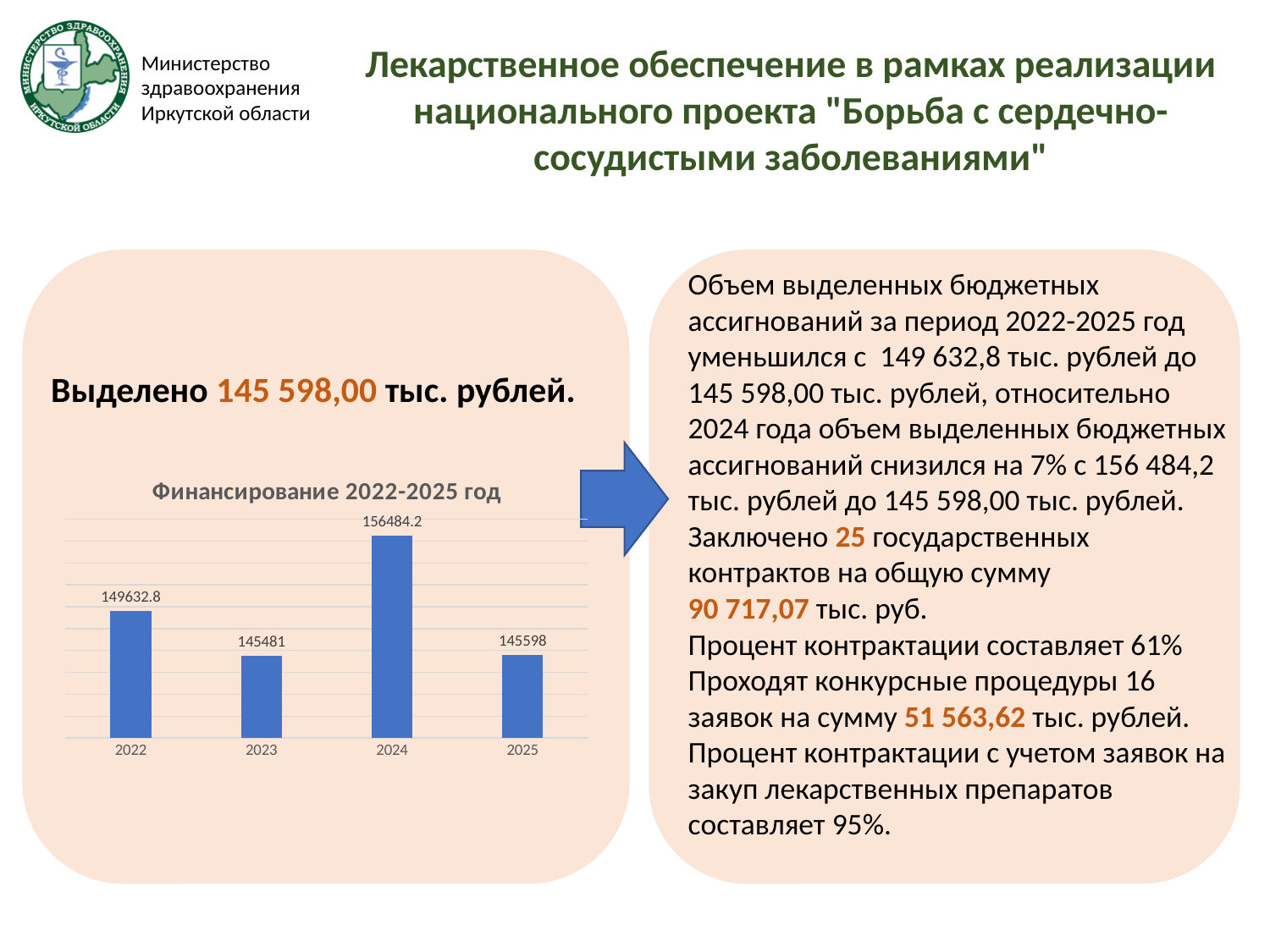
What is the value for 2025 in the chart? 145598 What is the value for 2022 in the chart? 149632.8 Which year has the highest value in the chart? 2024 What is the title of the chart? Финансирование 2022-2025 год Which is larger, the value for 2022 or the value for 2025? 2022 How many years are shown in the chart? 4 What is the difference between the values for 2024 and 2022? 6851.4 What is the value for 2023 in the chart? 145481 Which year has the lowest value in the chart? 2023 What is the value for 2024 in the chart? 156484.2 What is the difference between the values for 2024 and 2025? 10886.2 What kind of chart is shown on the slide? bar chart